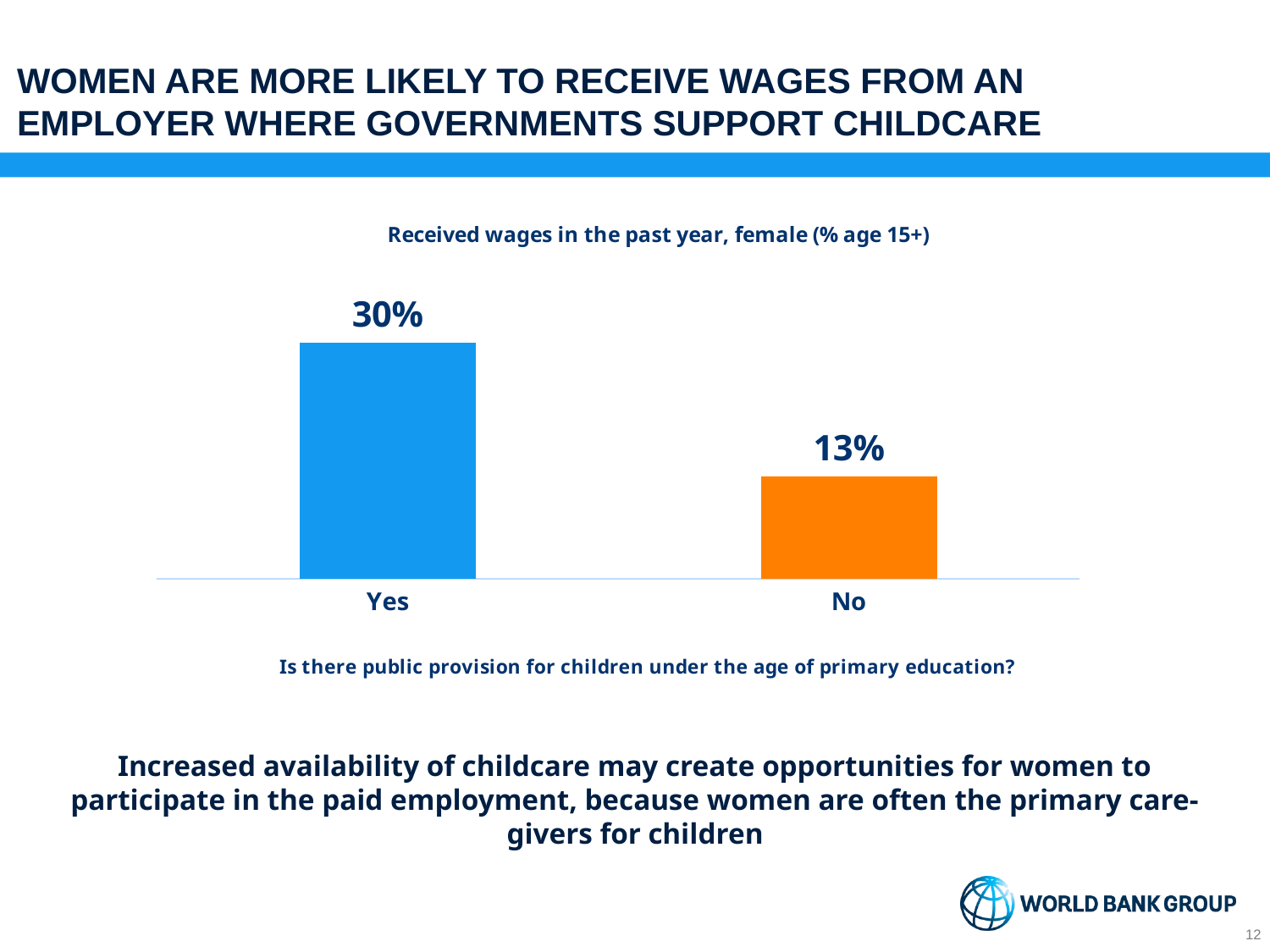
Which category has the highest value? Yes Which category has the lowest value? No What is the title of the chart? Received wages in the past year, female (% age 15+) What kind of chart is shown on the slide? Bar chart What colour is the bar for "No"? Orange Which is larger, the value for "Yes" or the value for "No"? Yes What is the value for "No" in the chart? 13% How many categories are shown in the chart? 2 What is the value for "Yes" in the chart? 30% Do the values rise or fall from "Yes" to "No"? Fall What is the difference between the values for "Yes" and "No"? 17%